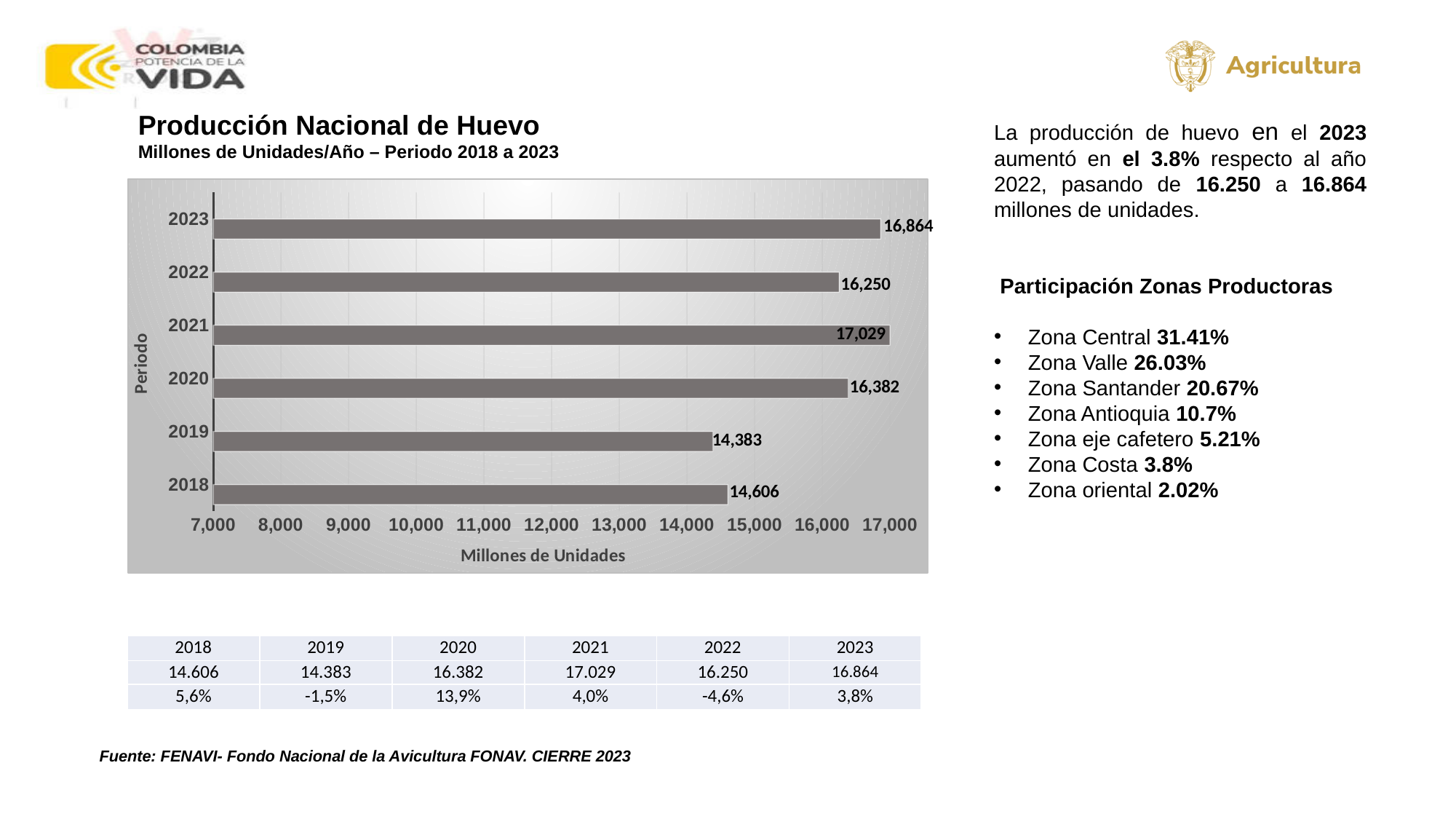
What is the difference between the values for 2021 and 2020 in the Producción Nacional de Huevo chart? 647 Is the value for 2022 in the Producción Nacional de Huevo chart greater or less than 16,000? greater What is the value for 2020 in the Producción Nacional de Huevo chart? 16,382 What is the difference between the values for 2023 and 2022 in the Producción Nacional de Huevo chart? 614 What is the label of the horizontal axis in the Producción Nacional de Huevo chart? Millones de Unidades Which year has the highest value in the Producción Nacional de Huevo chart? 2021 In the Producción Nacional de Huevo chart, which is larger, the value for 2018 or the value for 2019? 2018 What is the value for 2019 in the Producción Nacional de Huevo chart? 14,383 Which year has the lowest value in the Producción Nacional de Huevo chart? 2019 How many years are shown in the Producción Nacional de Huevo chart? 6 What is the value for 2023 in the Producción Nacional de Huevo chart? 16,864 What kind of chart is the Producción Nacional de Huevo chart? bar chart